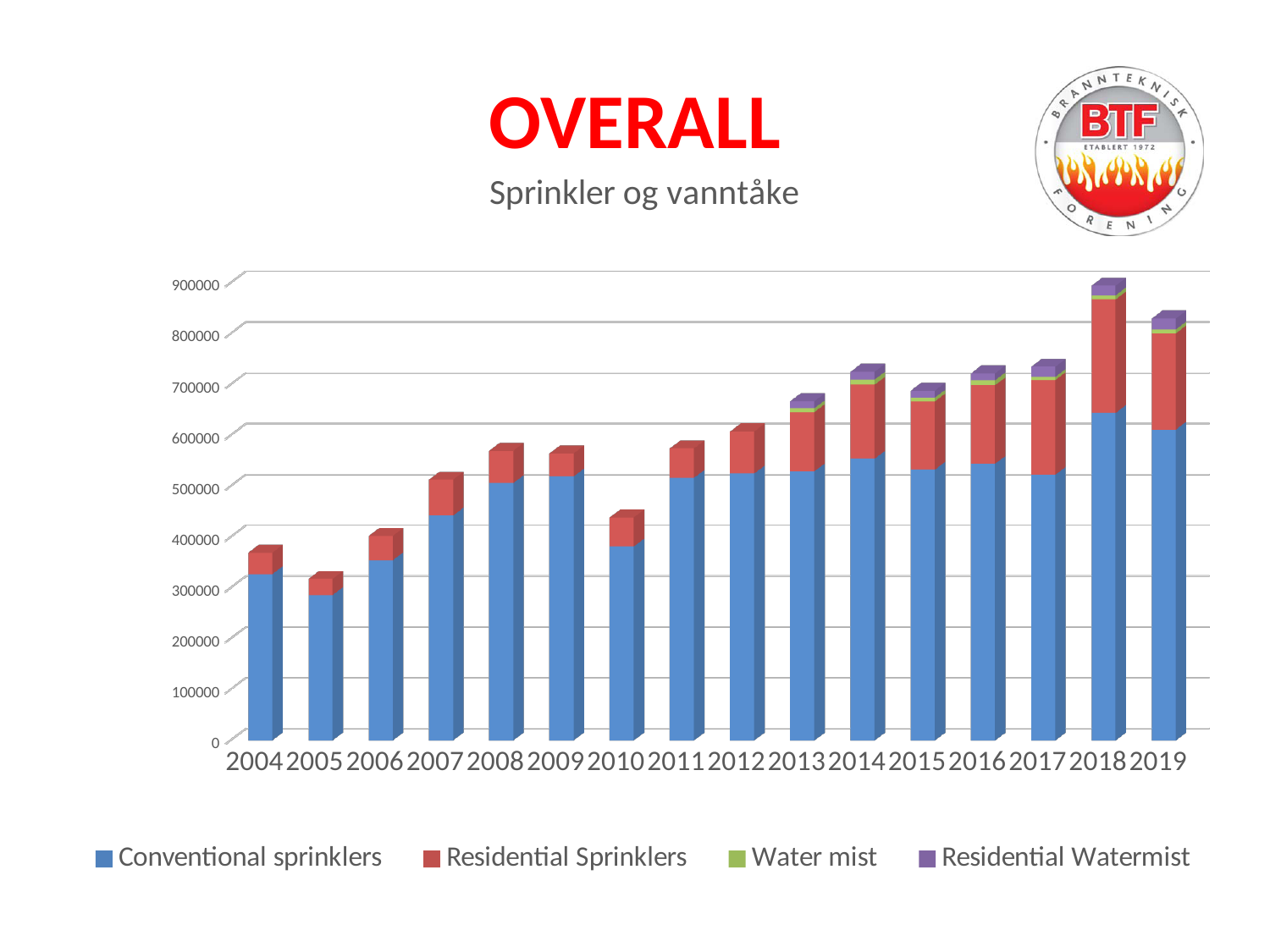
Which colour represents Conventional sprinklers in the legend? Blue How many years are shown on the x axis of the chart? 16 Is the total bar for 2010 greater or less than 500000? less Is the total bar for 2005 greater or less than 400000? less Which year has the larger total bar, 2018 or 2019? 2018 What kind of chart is shown on the slide? Stacked bar chart How many series does the chart's legend list? 4 Is the total bar for 2018 greater or less than 800000? greater Do the total bars generally rise or fall from 2004 to 2019? rise Which year has the highest total bar? 2018 Which year has the lowest total bar? 2005